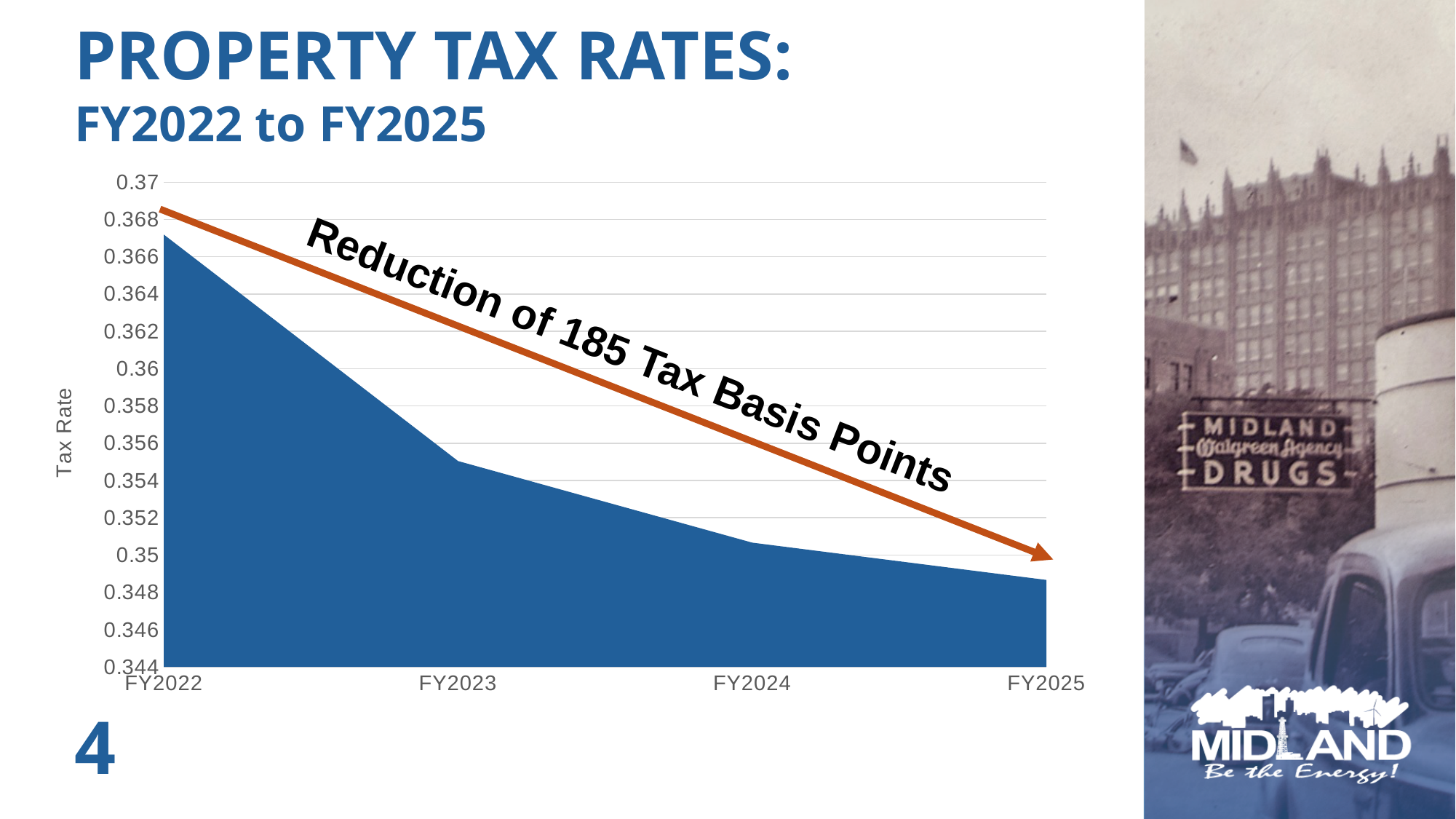
Is the tax rate for FY2023 greater or less than 0.358? less Which fiscal year has the highest tax rate in the chart? FY2022 Which has the larger tax rate, FY2023 or FY2025? FY2023 Is the tax rate for FY2024 greater or less than 0.352? less How many fiscal years are plotted on the x axis of the chart? 4 Which fiscal year has the lowest tax rate in the chart? FY2025 Is the tax rate for FY2022 greater or less than 0.364? greater What is the label on the y axis of the chart? Tax Rate What does the annotation along the arrow on the chart say? Reduction of 185 Tax Basis Points Do the tax rate values rise or fall from FY2022 to FY2025? Fall What kind of chart is shown on the slide? Area chart